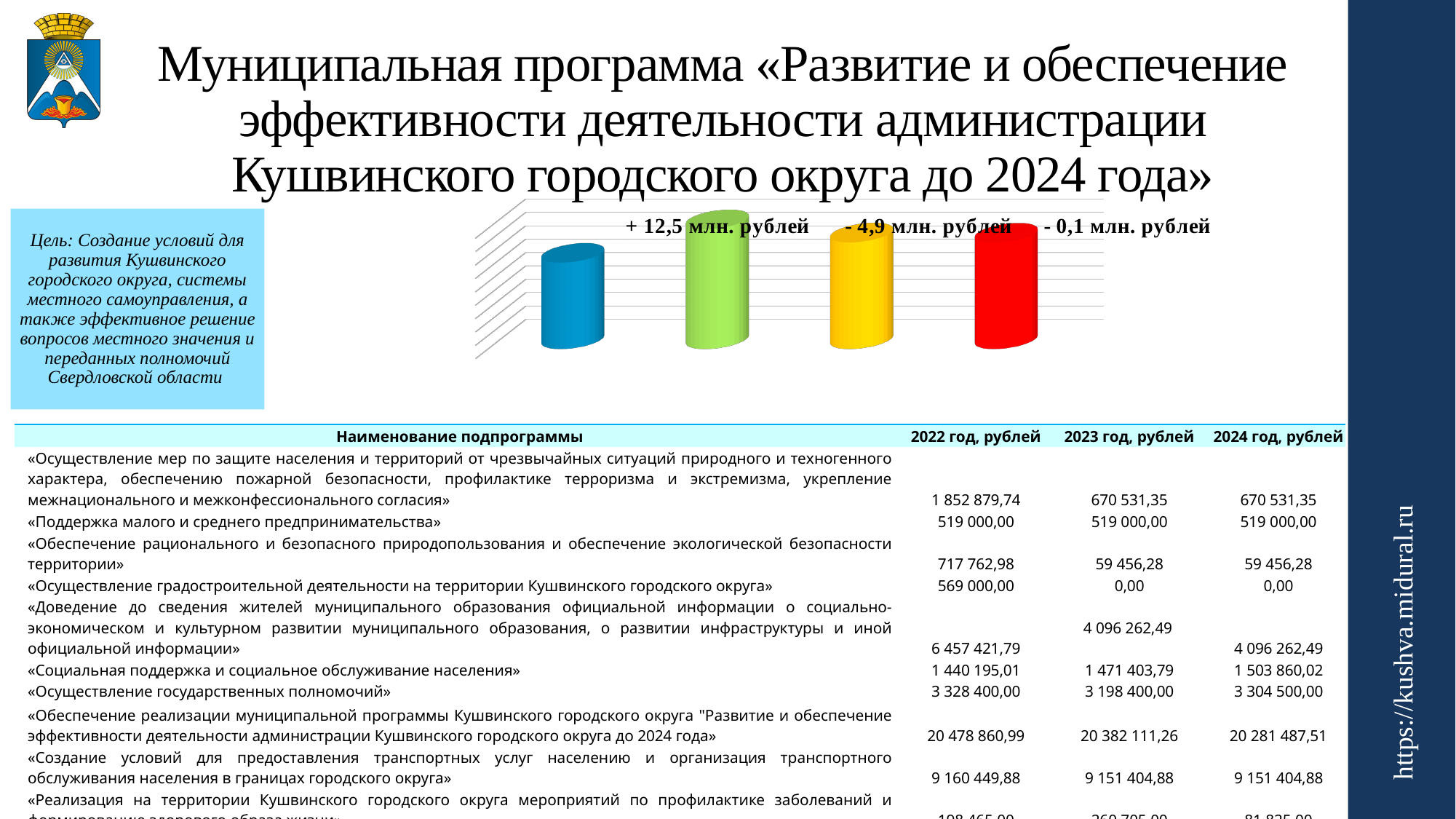
What colour is the first (leftmost) bar in the chart? blue What kind of chart is shown on the slide? bar chart Which is taller in the chart, the green bar or the blue bar? the green bar How many bars does the chart on the slide contain? 4 Which bar in the chart is the shortest? the blue bar What colour is the last (rightmost) bar in the chart? red Which bar in the chart is the tallest? the green bar